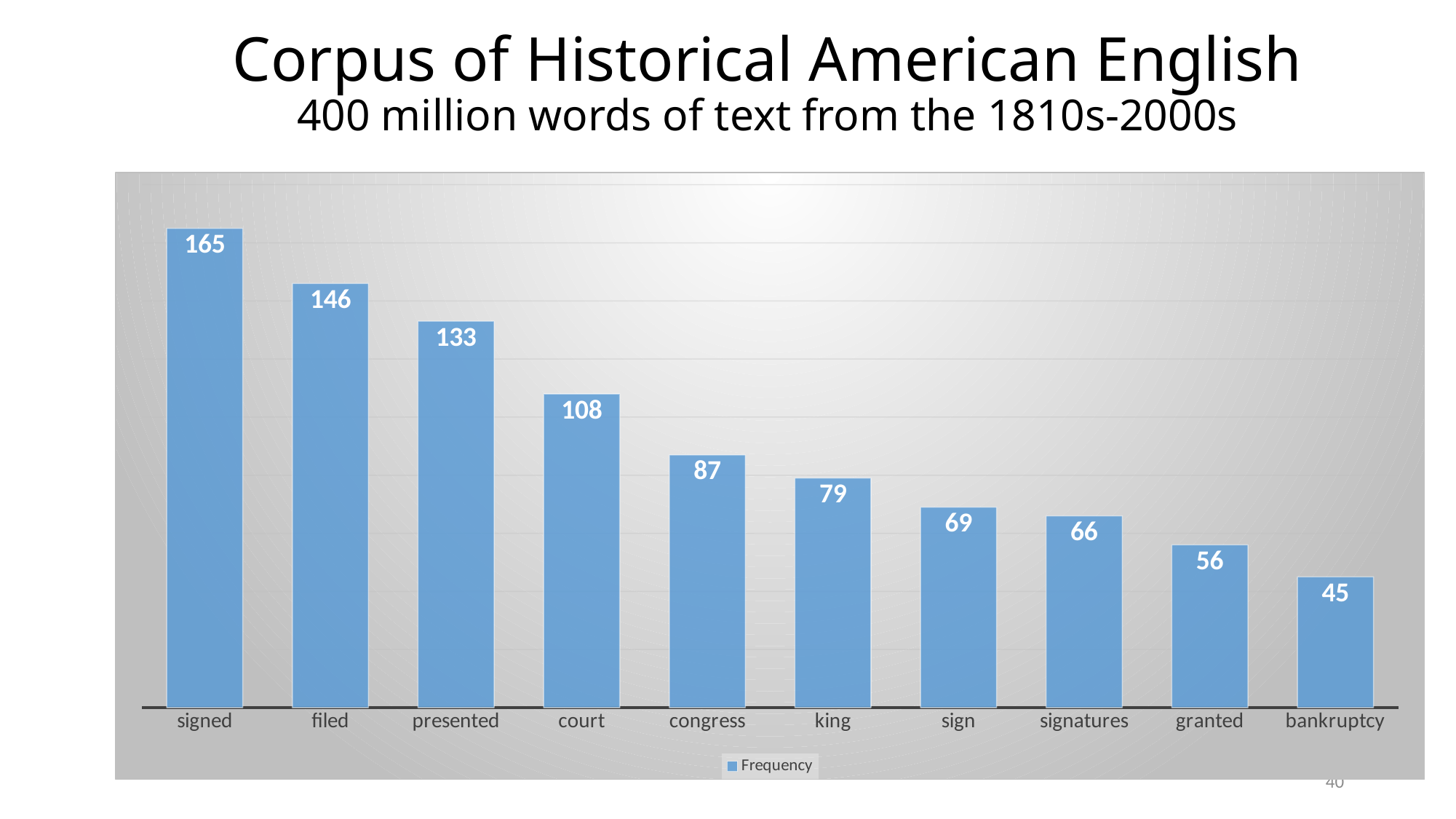
Which category has the lowest Frequency? bankruptcy How many categories are shown on the x axis? 10 Which has a higher Frequency, "king" or "sign"? king What is the difference between the Frequency values for "congress" and "granted"? 31 How many series does the legend list? 1 What is the Frequency value for "court"? 108 Do the Frequency values rise or fall from left to right along the x axis? fall What kind of chart is shown on the slide? bar chart Which category has the highest Frequency? signed What is the difference between the Frequency values for "signed" and "filed"? 19 What is the Frequency value for "signatures"? 66 What is the name of the series listed in the legend? Frequency